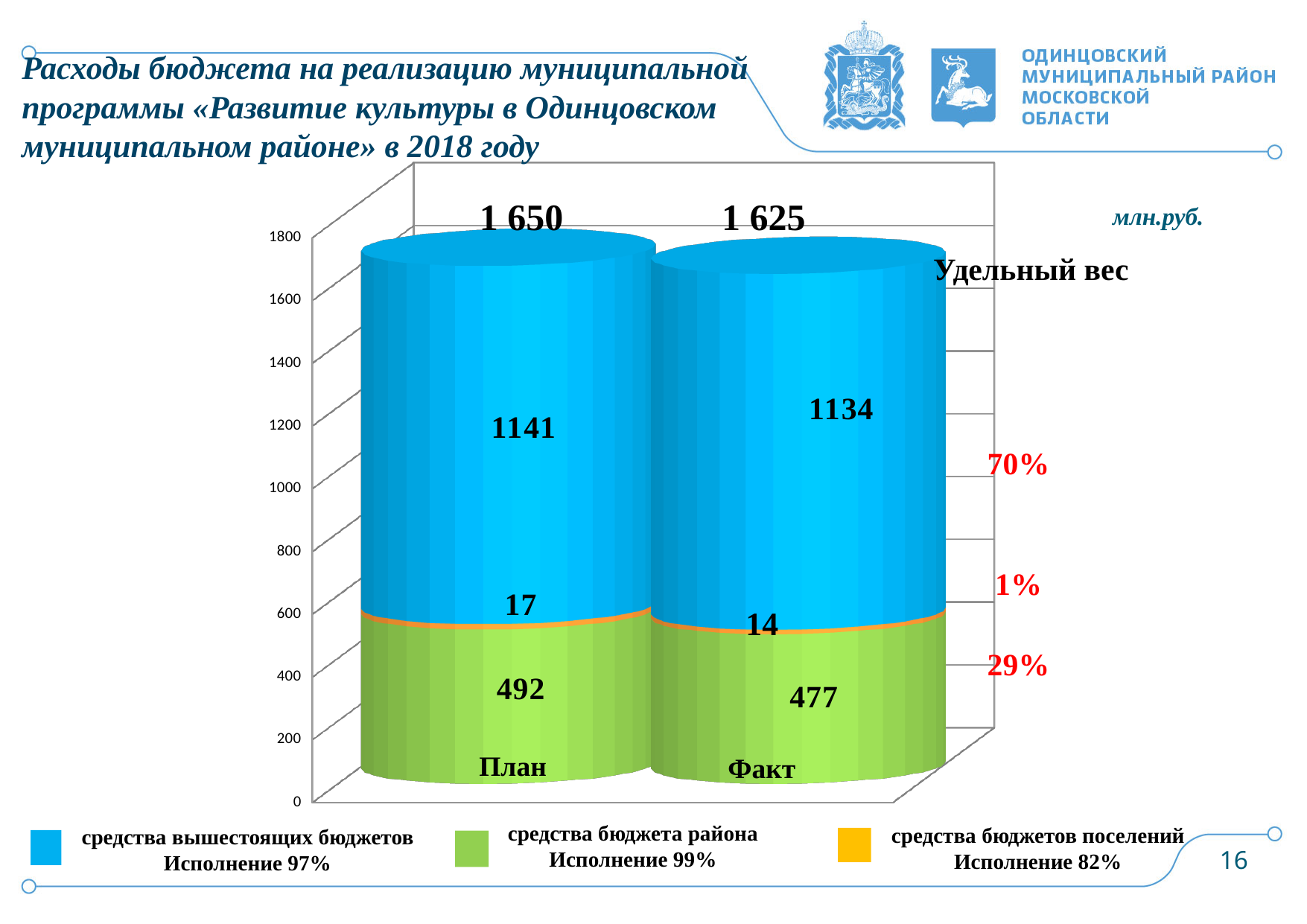
What is the value of средства бюджетов поселений for План? 17 How many series does the legend list? 3 What is the value of средства вышестоящих бюджетов for План? 1141 What share (Удельный вес) is shown for средства вышестоящих бюджетов? 70% What is the total shown above the План bar? 1 650 What is the total shown above the Факт bar? 1 625 What is the value of средства бюджета района for Факт? 477 What is the difference between средства бюджета района for План and for Факт? 15 What kind of chart is shown on the slide? Stacked bar chart What unit is indicated for the chart values? млн.руб. How many categories are shown on the x axis? 2 Which is larger, средства вышестоящих бюджетов for План or for Факт? План